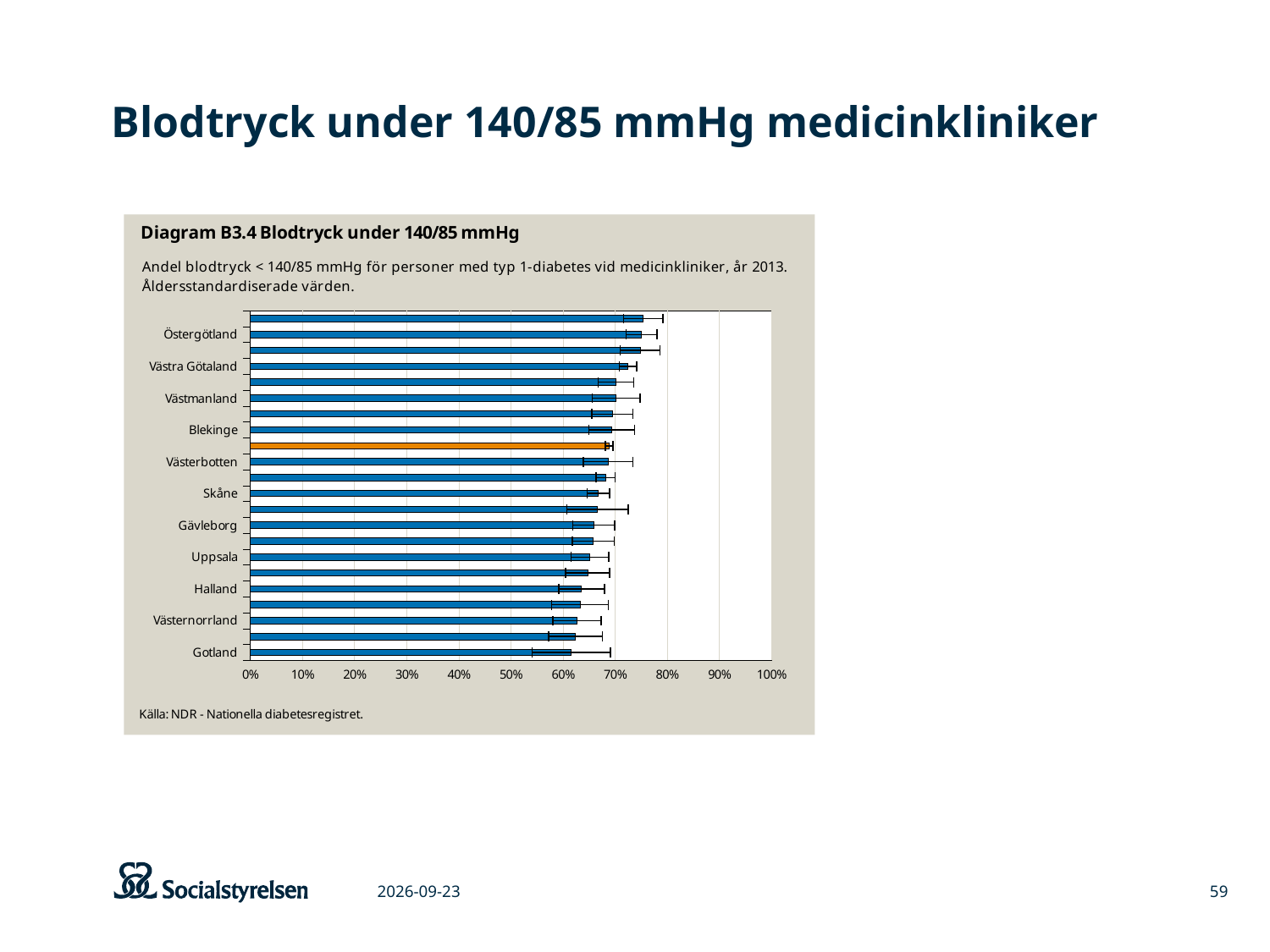
Is the value for Västra Götaland greater or less than 70%? greater Which has the larger value, Västra Götaland or Halland? Västra Götaland Do the bar values increase or decrease going from the top of the chart to the bottom? decrease Is the value for Östergötland greater or less than 70%? greater Is the value for Halland greater or less than 70%? less Which has the larger value, Östergötland or Gotland? Östergötland What is the title of the diagram shown on the slide? Diagram B3.4 Blodtryck under 140/85 mmHg What kind of chart is shown on the slide? bar chart Of the labelled regions, which has the lowest value? Gotland